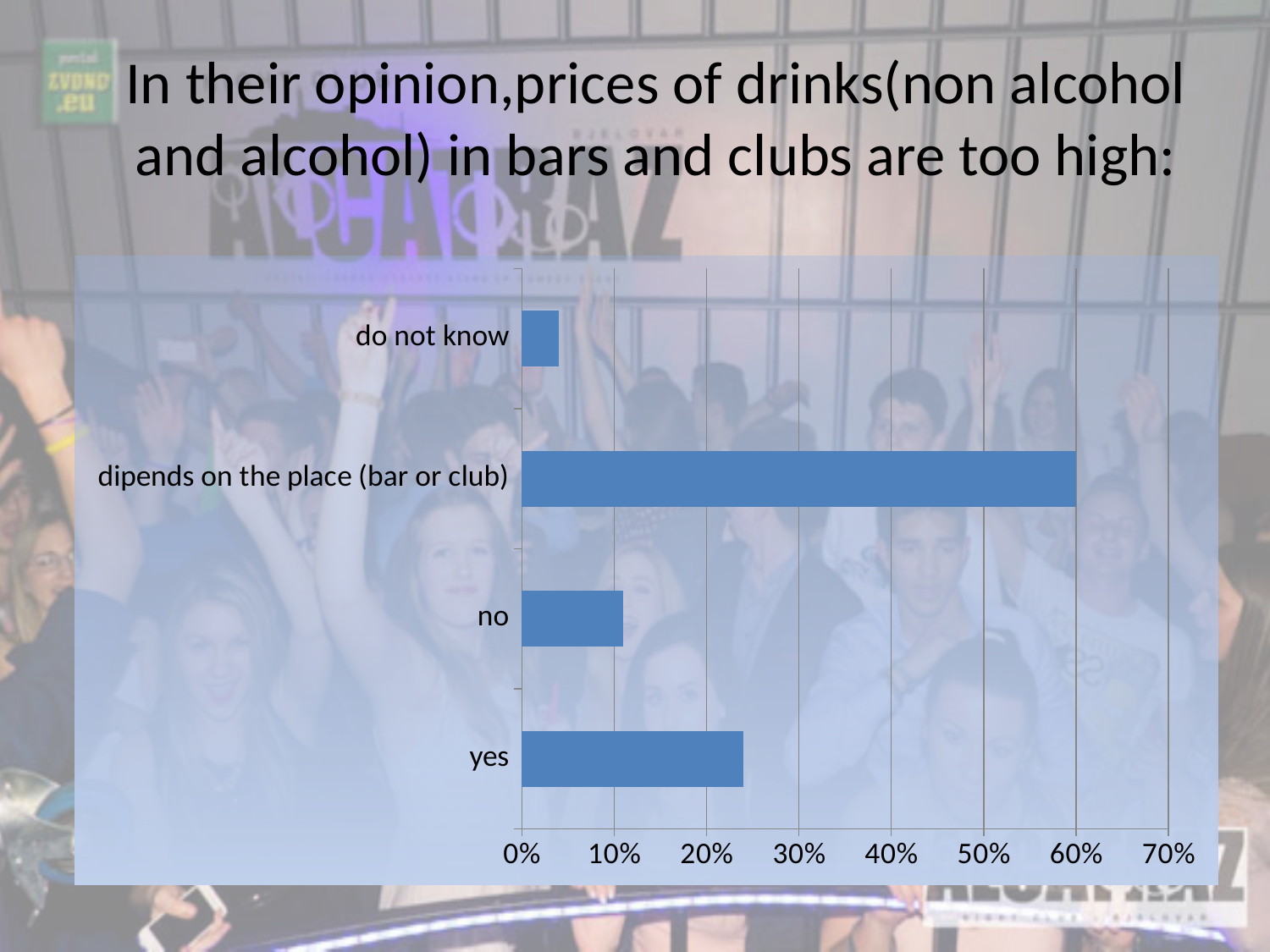
Which category has the highest value? dipends on the place (bar or club) Is the value for "yes" greater or less than 20%? greater What kind of chart is shown on the slide? bar chart Is the value for "no" greater or less than 20%? less Is the value for "do not know" greater or less than 10%? less Which category has the lowest value? do not know Which is larger, the value for "no" or the value for "do not know"? no How many categories are plotted in the chart? 4 What is the highest value shown on the horizontal axis? 70% Which is larger, the value for "yes" or the value for "no"? yes What is the value for "dipends on the place (bar or club)"? 60% What is the title of the slide containing the chart? In their opinion,prices of drinks(non alcohol and alcohol) in bars and clubs are too high: